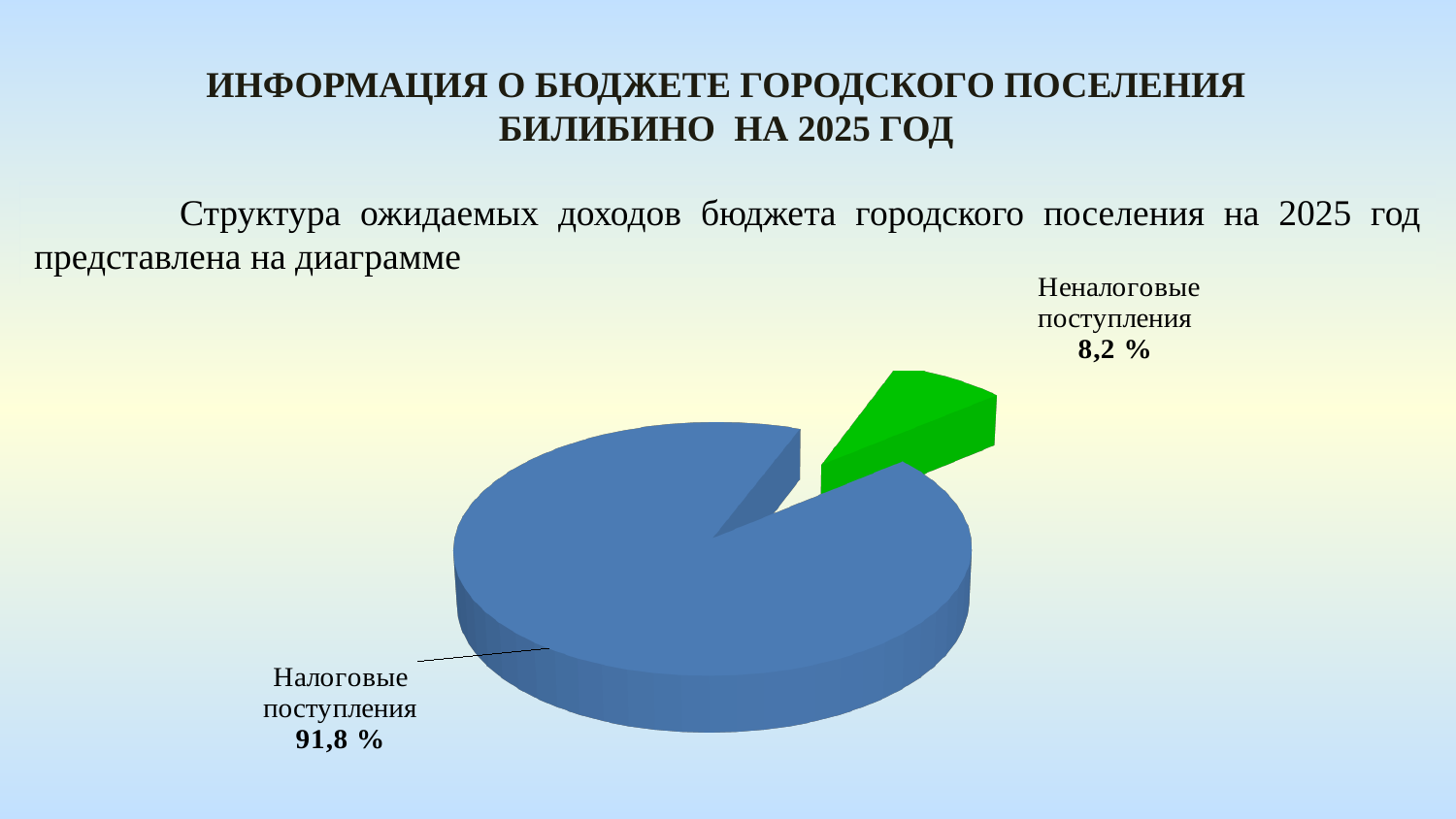
What is the difference in percentage points between Налоговые поступления and Неналоговые поступления? 83,6 What share of the pie is labelled Неналоговые поступления? 8,2 % What is the total of the two slice percentages shown on the pie chart? 100 % What colour is the slice for Неналоговые поступления? green How many slices does the pie chart have? 2 What colour is the slice for Налоговые поступления? blue What share of the pie is labelled Налоговые поступления? 91,8 % Which slice of the pie is the largest? Налоговые поступления Which is larger: Налоговые поступления or Неналоговые поступления? Налоговые поступления What kind of chart is shown on the slide? pie chart Which slice of the pie is the smallest? Неналоговые поступления